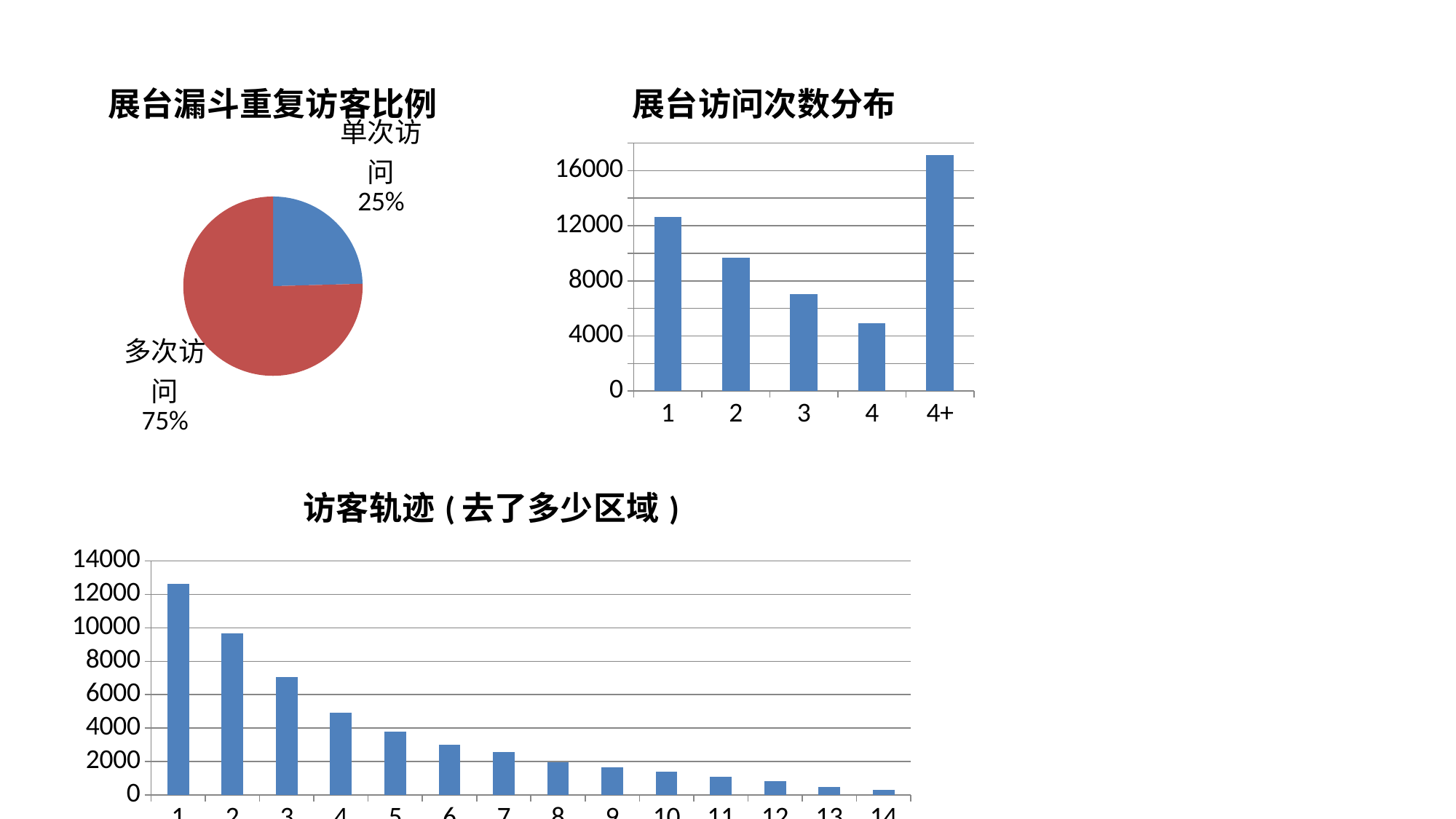
In the chart titled 访客轨迹（去了多少区域）, do the values rise or fall from category 1 to category 14? fall In the chart titled 展台访问次数分布, is the value for category 4+ greater or less than 16000? greater In the chart titled 展台访问次数分布, which category has the highest value? 4+ In the chart titled 展台漏斗重复访客比例, what share of the pie is 多次访问? 75% What kind of chart is the one titled 访客轨迹（去了多少区域）? bar chart In the chart titled 展台访问次数分布, how many categories are shown on the x axis? 5 In the chart titled 展台漏斗重复访客比例, what share of the pie is 单次访问? 25% In the chart titled 展台访问次数分布, which category has the lowest value? 4 In the chart titled 访客轨迹（去了多少区域）, how many categories are shown on the x axis? 14 In the chart titled 访客轨迹（去了多少区域）, which is larger, the value for category 2 or the value for category 5? 2 What kind of chart is the one titled 展台漏斗重复访客比例? pie chart In the chart titled 展台访问次数分布, is the value for category 1 greater or less than 12000? greater